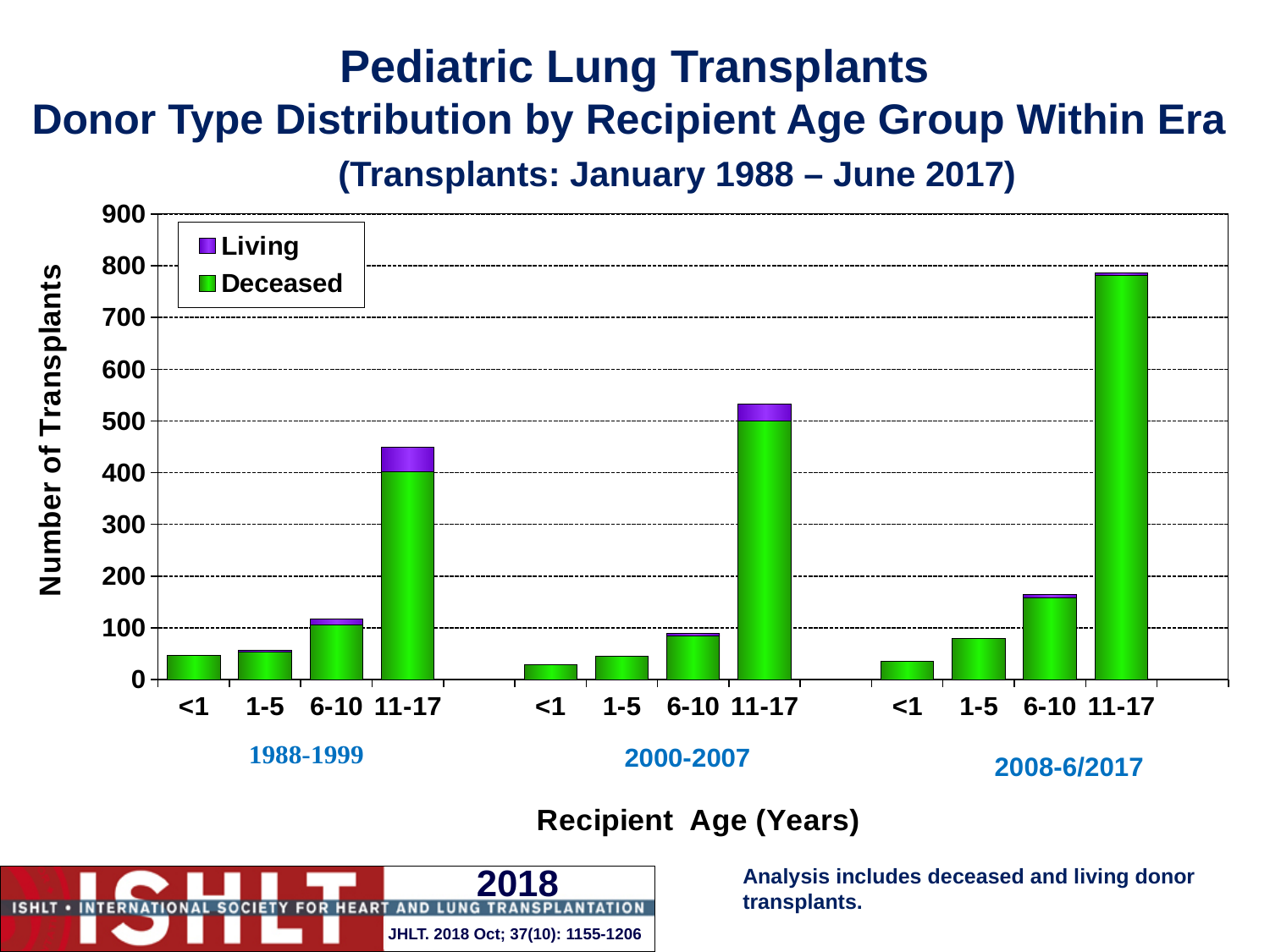
How many series does the legend list? 2 Which is larger: the 11-17 bar in 2000-2007 or the 11-17 bar in 1988-1999? 11-17 in 2000-2007 Within the 2008-6/2017 era, which age group has the lowest number of transplants? <1 Is the total for the 11-17 age group in 2008-6/2017 greater or less than 700? greater Is the total for the 6-10 age group in 2008-6/2017 greater or less than 100? greater How many bars are plotted in total across all eras? 12 Within each era, do the bars rise or fall as recipient age group increases from <1 to 11-17? rise What kind of chart is shown on the slide? bar chart Which age group and era has the tallest bar? 11-17 in 2008-6/2017 Is the total for the 11-17 age group in 1988-1999 greater or less than 500? less What are the two series named in the legend? Living and Deceased How many era groups are shown along the x axis? 3